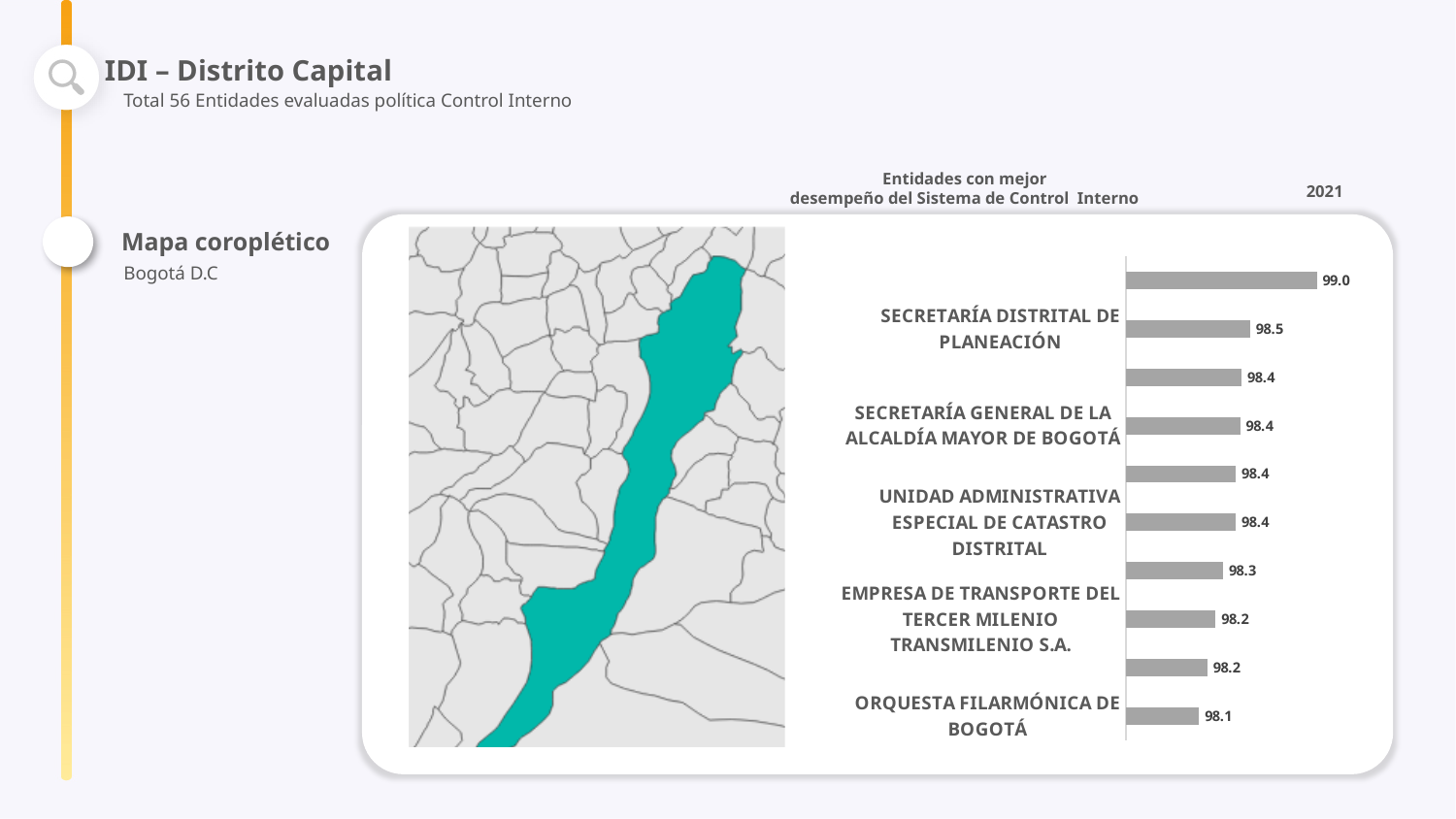
What type of chart is shown on the slide? bar chart What is the value for SECRETARÍA GENERAL DE LA ALCALDÍA MAYOR DE BOGOTÁ? 98.4 What is the highest value shown in the chart? 99.0 Which labelled entity has the lowest value in the chart? ORQUESTA FILARMÓNICA DE BOGOTÁ What is the difference between the values for SECRETARÍA DISTRITAL DE PLANEACIÓN and ORQUESTA FILARMÓNICA DE BOGOTÁ? 0.4 What is the value for SECRETARÍA DISTRITAL DE PLANEACIÓN? 98.5 Which has a larger value, SECRETARÍA DISTRITAL DE PLANEACIÓN or EMPRESA DE TRANSPORTE DEL TERCER MILENIO TRANSMILENIO S.A.? SECRETARÍA DISTRITAL DE PLANEACIÓN What is the value for UNIDAD ADMINISTRATIVA ESPECIAL DE CATASTRO DISTRITAL? 98.4 What is the value for ORQUESTA FILARMÓNICA DE BOGOTÁ? 98.1 What is the value for EMPRESA DE TRANSPORTE DEL TERCER MILENIO TRANSMILENIO S.A.? 98.2 How many bars are plotted in the chart? 10 Which year does the chart refer to? 2021